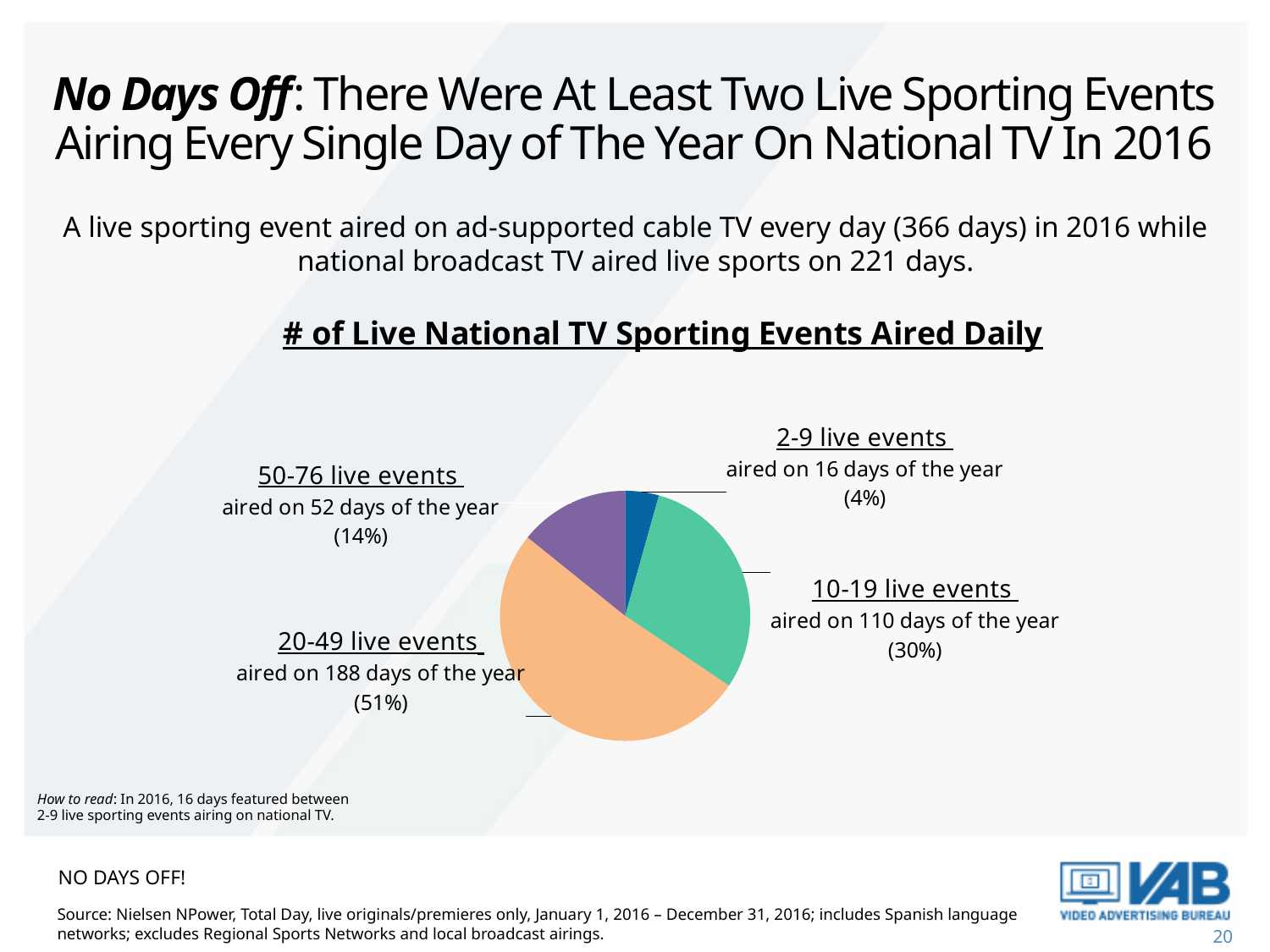
On how many days of the year were 10-19 live events aired? 110 days On how many days of the year were 2-9 live events aired? 16 days What share of the pie does the 20-49 live events slice represent? 51% What share of the pie does the 50-76 live events slice represent? 14% On how many days of the year were 20-49 live events aired? 188 days Which category accounts for the smallest slice of the pie? 2-9 live events What kind of chart is shown on the slide? pie chart What is the title of the pie chart? # of Live National TV Sporting Events Aired Daily How many slices does the pie chart have? 4 How many more days had 10-19 live events than 50-76 live events? 58 days Which category accounts for the largest slice of the pie? 20-49 live events Which had more days: 10-19 live events or 50-76 live events? 10-19 live events